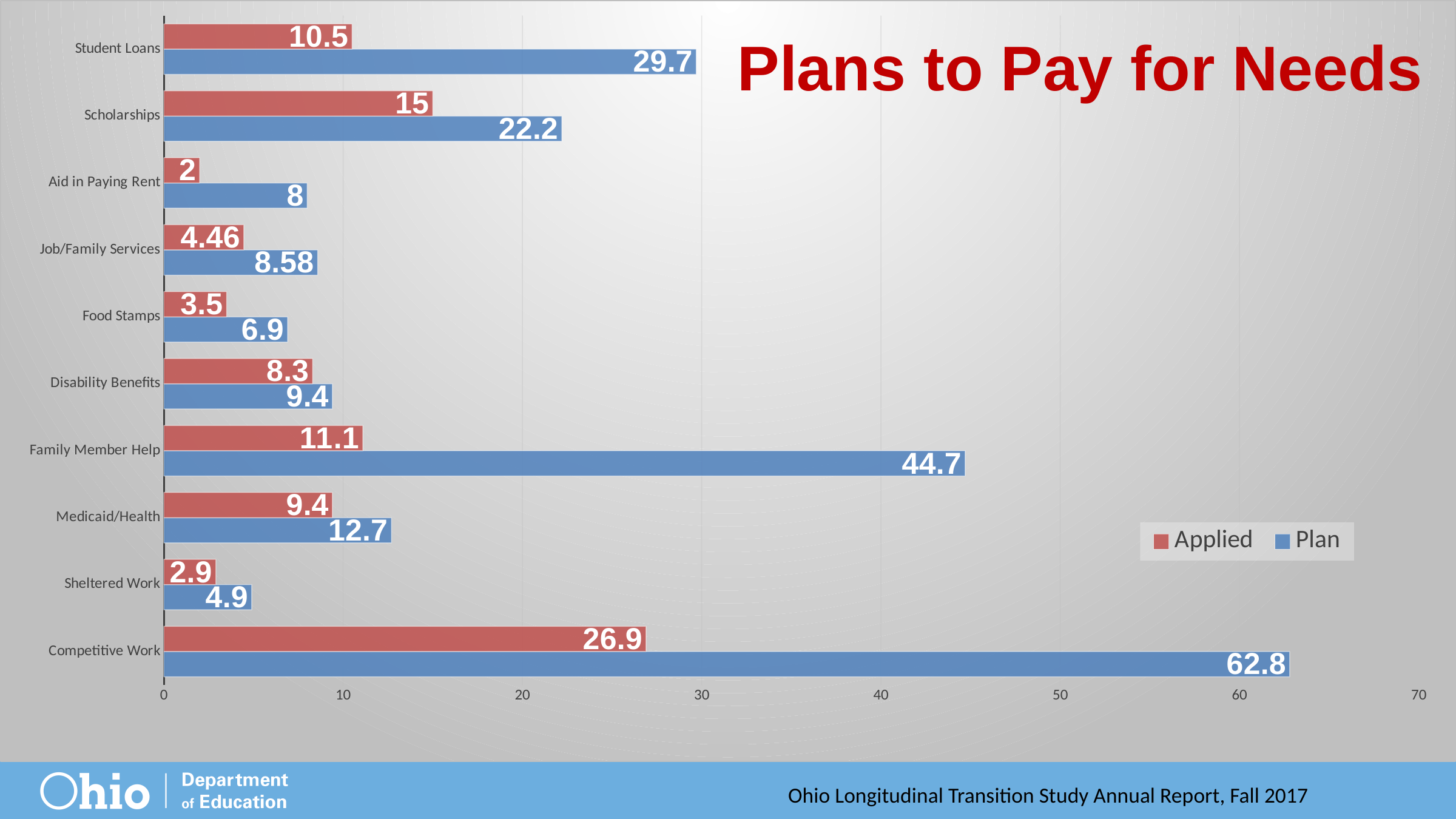
What is the Plan value for Job/Family Services? 8.58 What is the Applied value for Scholarships? 15 Which is larger, the Applied value for Student Loans or the Applied value for Family Member Help? Family Member Help What is the title of the chart? Plans to Pay for Needs Which category has the lowest Applied value? Aid in Paying Rent How many categories are shown on the chart? 10 What is the Plan value for Competitive Work? 62.8 How many series does the legend list? 2 What is the difference between the Plan and Applied values for Family Member Help? 33.6 Which category has the highest Plan value? Competitive Work What kind of chart is shown on the slide? bar chart Is the Plan value for Competitive Work greater or less than 60? greater